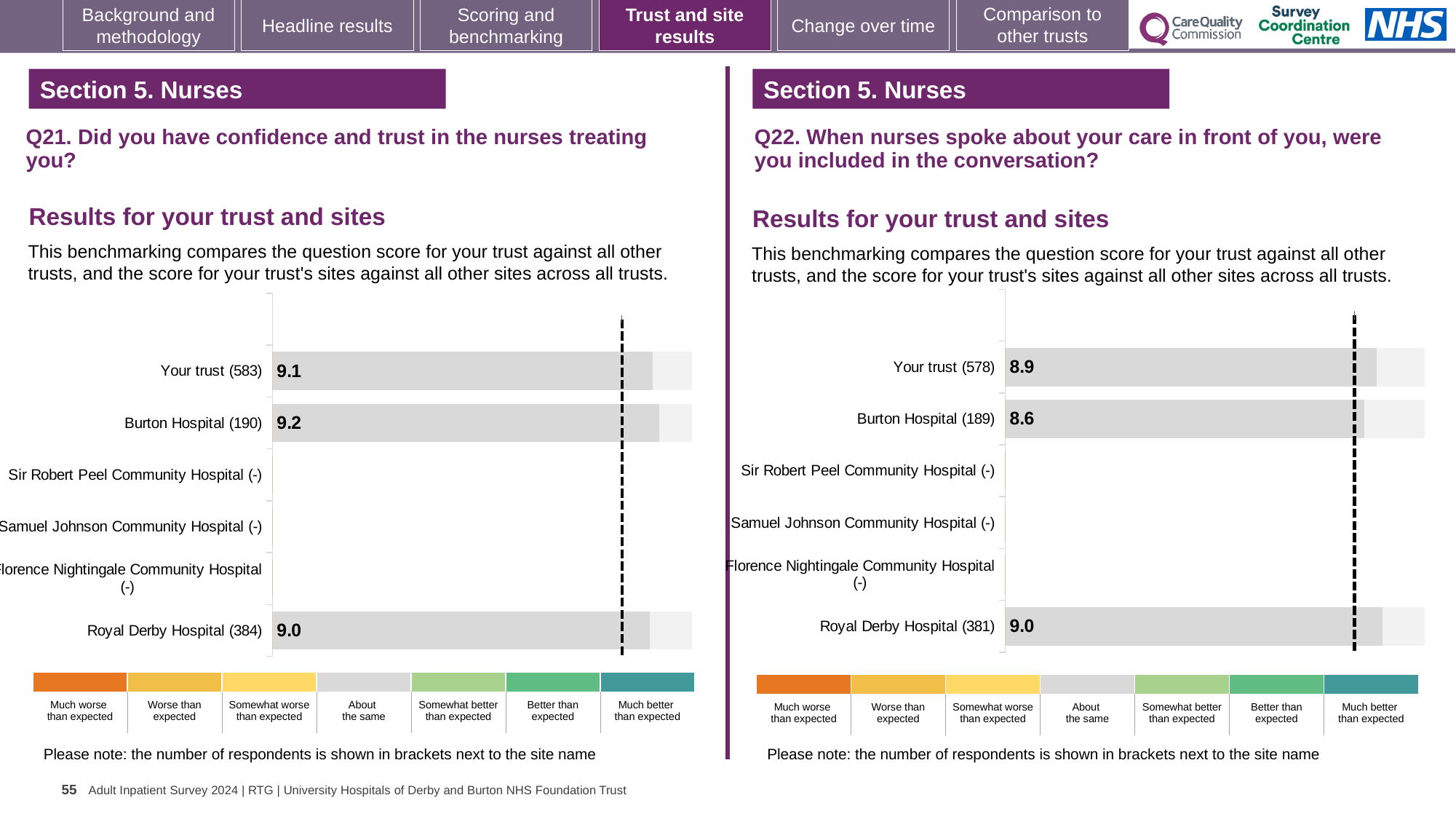
What kind of chart is used in the Q21 chart on the left? Bar chart In the Q21 chart on the left, which site has the highest score? Burton Hospital (190) In the Q22 chart on the right, how many sites have a score plotted as a bar? 3 In the Q22 chart on the right, which site has the lowest score? Burton Hospital (189) In the Q21 chart on the left, how many site rows are listed on the vertical axis, including Your trust? 6 In the Q22 chart on the right, what is the score for Burton Hospital (189)? 8.6 In the Q21 chart on the left, which is larger, the score for Burton Hospital (190) or Royal Derby Hospital (384)? Burton Hospital (190) In the Q21 chart on the left, what is the score for Royal Derby Hospital (384)? 9.0 In the Q22 chart on the right, what is the score for Your trust (578)? 8.9 In the Q21 chart on the left, what is the score for Your trust (583)? 9.1 In the Q22 chart on the right, what is the difference between the scores for Royal Derby Hospital (381) and Burton Hospital (189)? 0.4 In the Q21 chart on the left, what is the score for Burton Hospital (190)? 9.2